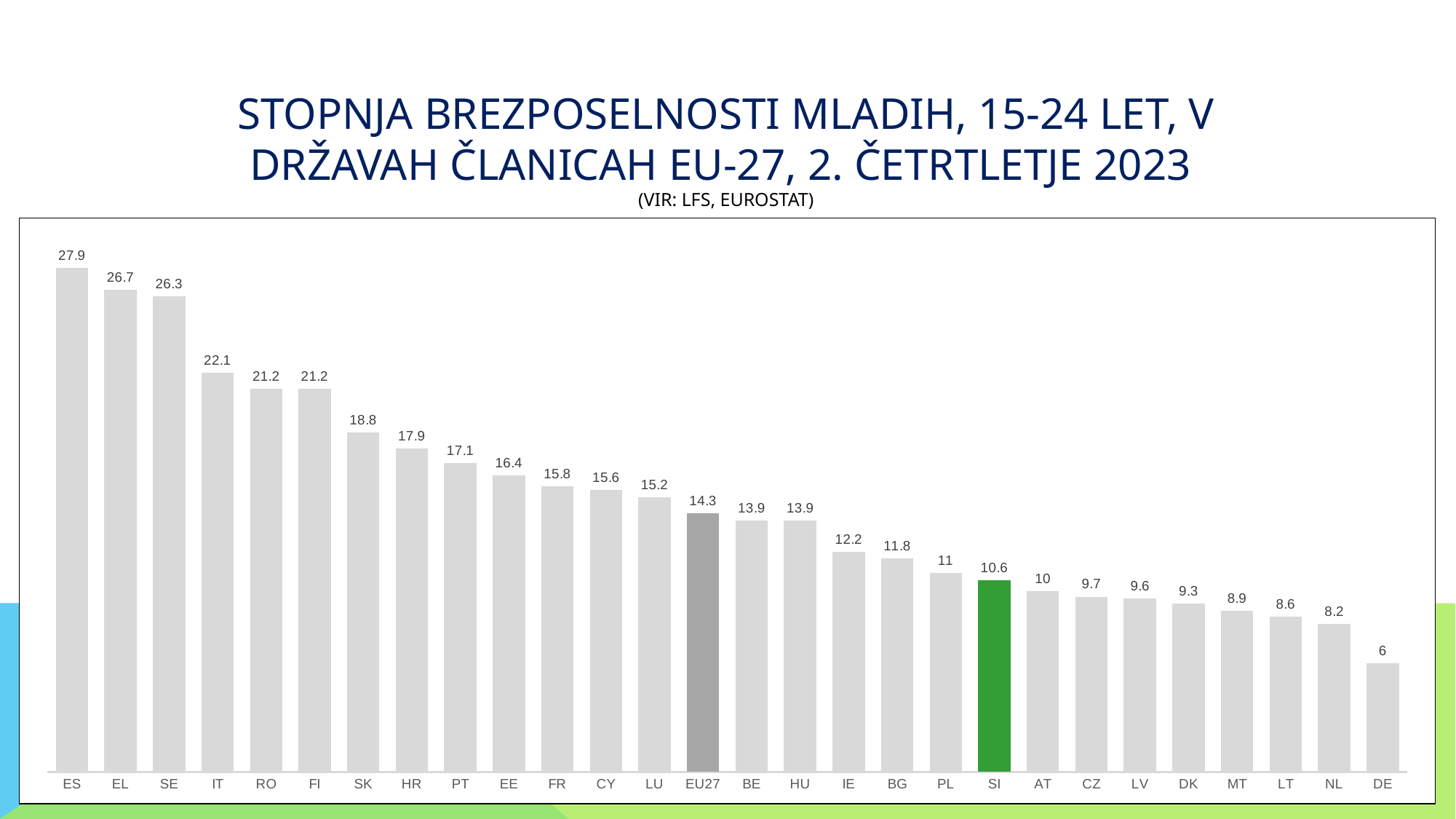
What is the value for DE? 6 What is the value for SI? 10.6 Which bar is coloured green? SI Which is larger, the value for IT or the value for SK? IT Which category has the lowest value? DE Do the values rise or fall from left to right along the x axis? Fall What is the difference between the values for EU27 and SI? 3.7 How many bars are shown in the chart? 28 What is the difference between the values for ES and DE? 21.9 Which category has the highest value? ES What is the value for EU27? 14.3 What kind of chart is shown on the slide? Bar chart